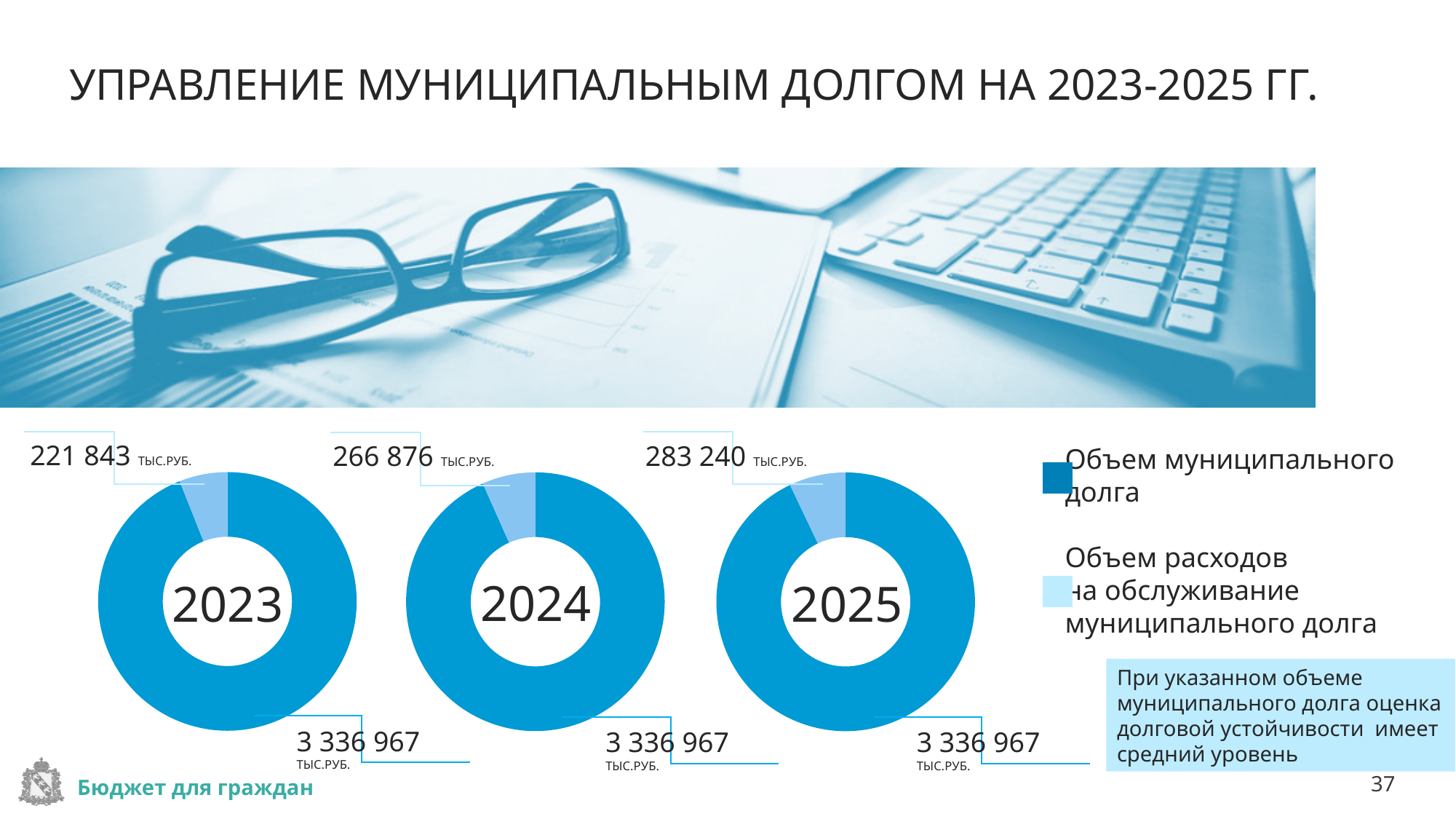
In the 2025 chart, which is larger: Объем муниципального долга or Объем расходов на обслуживание муниципального долга? Объем муниципального долга What is the difference between the 2024 and 2023 values for Объем расходов на обслуживание муниципального долга? 45 033 тыс.руб. What is the difference between the 2025 and 2024 values for Объем расходов на обслуживание муниципального долга? 16 364 тыс.руб. In the 2023 chart, what is the value for Объем муниципального долга? 3 336 967 тыс.руб. In the 2024 chart, what is the value for Объем расходов на обслуживание муниципального долга? 266 876 тыс.руб. How does the value for Объем расходов на обслуживание муниципального долга change from 2023 to 2025? It rises In the 2025 chart, what is the value for Объем расходов на обслуживание муниципального долга? 283 240 тыс.руб. Across the three charts, which year has the highest value for Объем расходов на обслуживание муниципального долга? 2025 How many series does the legend list for the charts? 2 In the 2023 chart, what is the value for Объем расходов на обслуживание муниципального долга? 221 843 тыс.руб. What kind of chart is used for each year on the slide? Pie chart (donut) Across the three charts, which year has the lowest value for Объем расходов на обслуживание муниципального долга? 2023